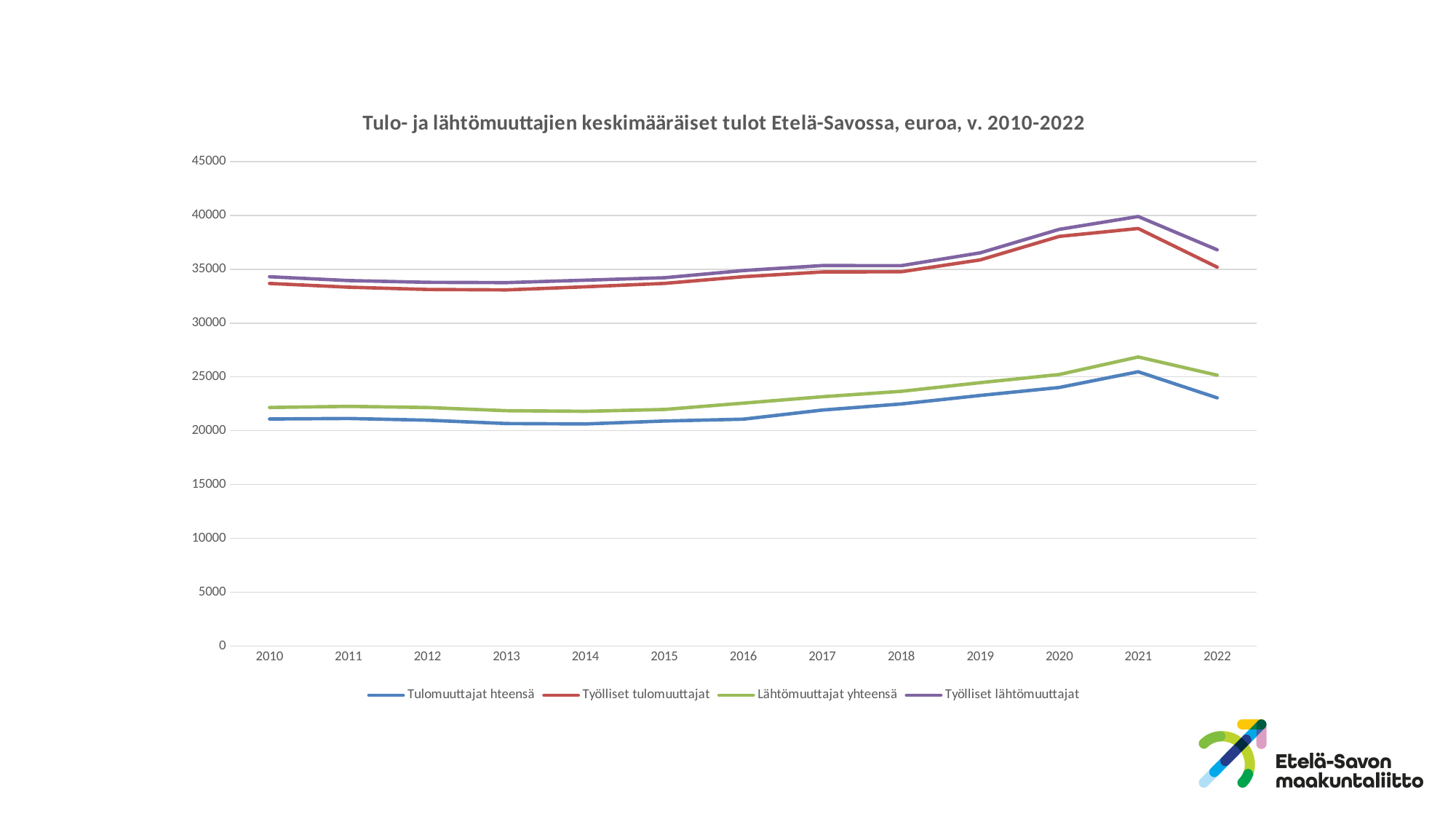
In 2022, which series has the higher value: Työlliset lähtömuuttajat or Työlliset tulomuuttajat? Työlliset lähtömuuttajat In 2010, which series has the higher value: Lähtömuuttajat yhteensä or Tulomuuttajat hteensä? Lähtömuuttajat yhteensä In which year does the Työlliset lähtömuuttajat series reach its highest value? 2021 Does the Tulomuuttajat hteensä series rise or fall between 2014 and 2021? rise Is the value for Tulomuuttajat hteensä in 2022 greater or less than 25000? less What is the title of the chart? Tulo- ja lähtömuuttajien keskimääräiset tulot Etelä-Savossa, euroa, v. 2010-2022 Is the value for Työlliset tulomuuttajat in 2010 greater or less than 35000? less What kind of chart is shown on the slide? Line chart How many years are shown on the x axis? 13 How many series does the legend list? 4 In which year does the Lähtömuuttajat yhteensä series reach its highest value? 2021 Is the value for Työlliset lähtömuuttajat in 2020 greater or less than 35000? greater